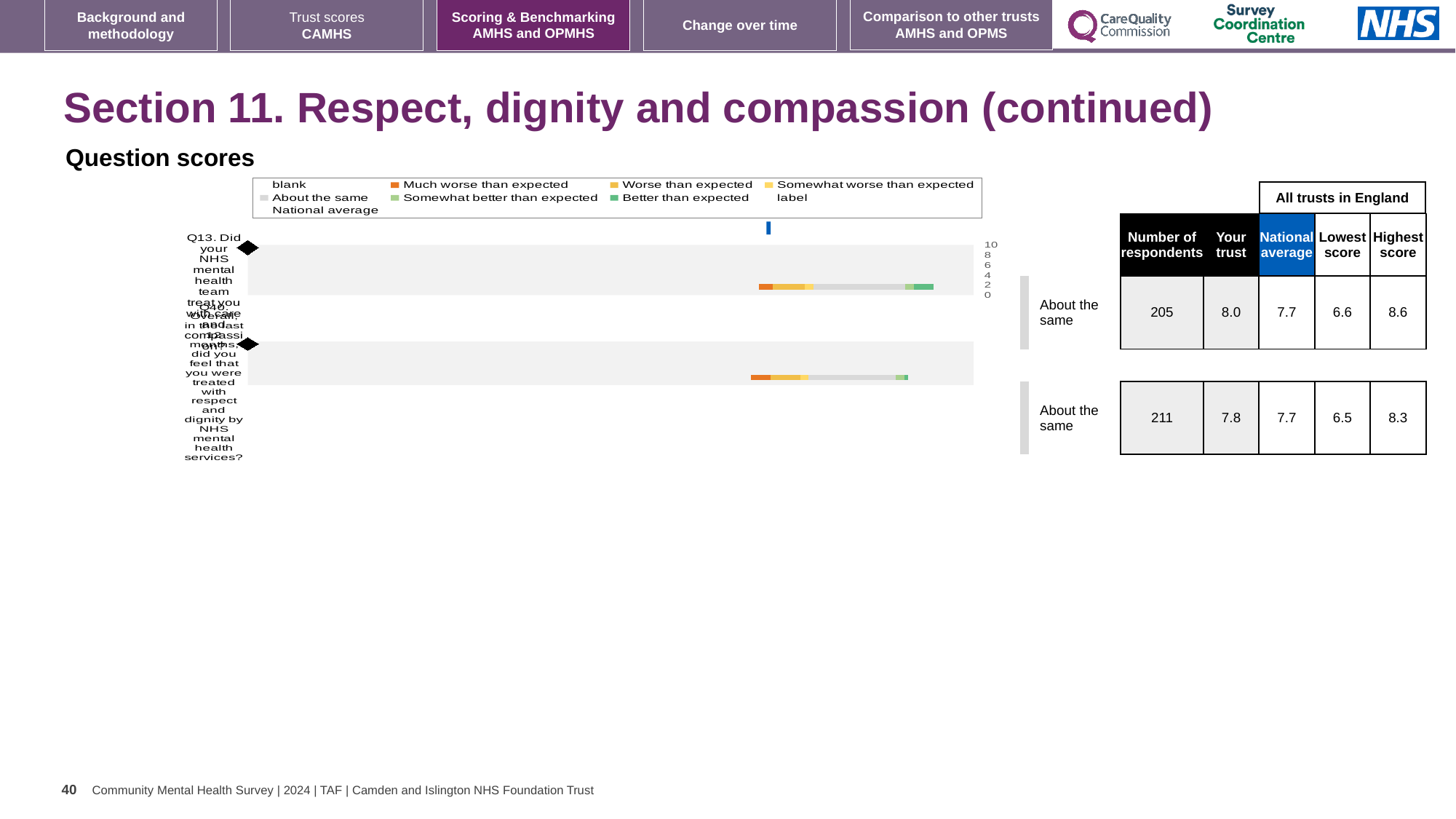
What is the difference between the 'Your trust' scores for Q13 and Q10? 0.2 In the table beside the chart, what is the 'Your trust' score for Q10? 7.8 What kind of chart is used to show the question scores? bar chart In the table beside the chart, how many respondents answered Q10? 211 Which question has the higher 'Your trust' score, Q13 or Q10? Q13 How many questions (categories) are plotted in the question scores chart? 2 How many entries does the legend of the question scores chart list? 9 In the table beside the chart, what is the highest score across all trusts in England for Q13? 8.6 In the table beside the chart, what is the lowest score across all trusts in England for Q10? 6.5 Which legend entry in the chart is shown in orange-red? Much worse than expected What is the highest tick value shown on the score axis of the chart? 10 In the table beside the chart, what is the 'Your trust' score for Q13? 8.0